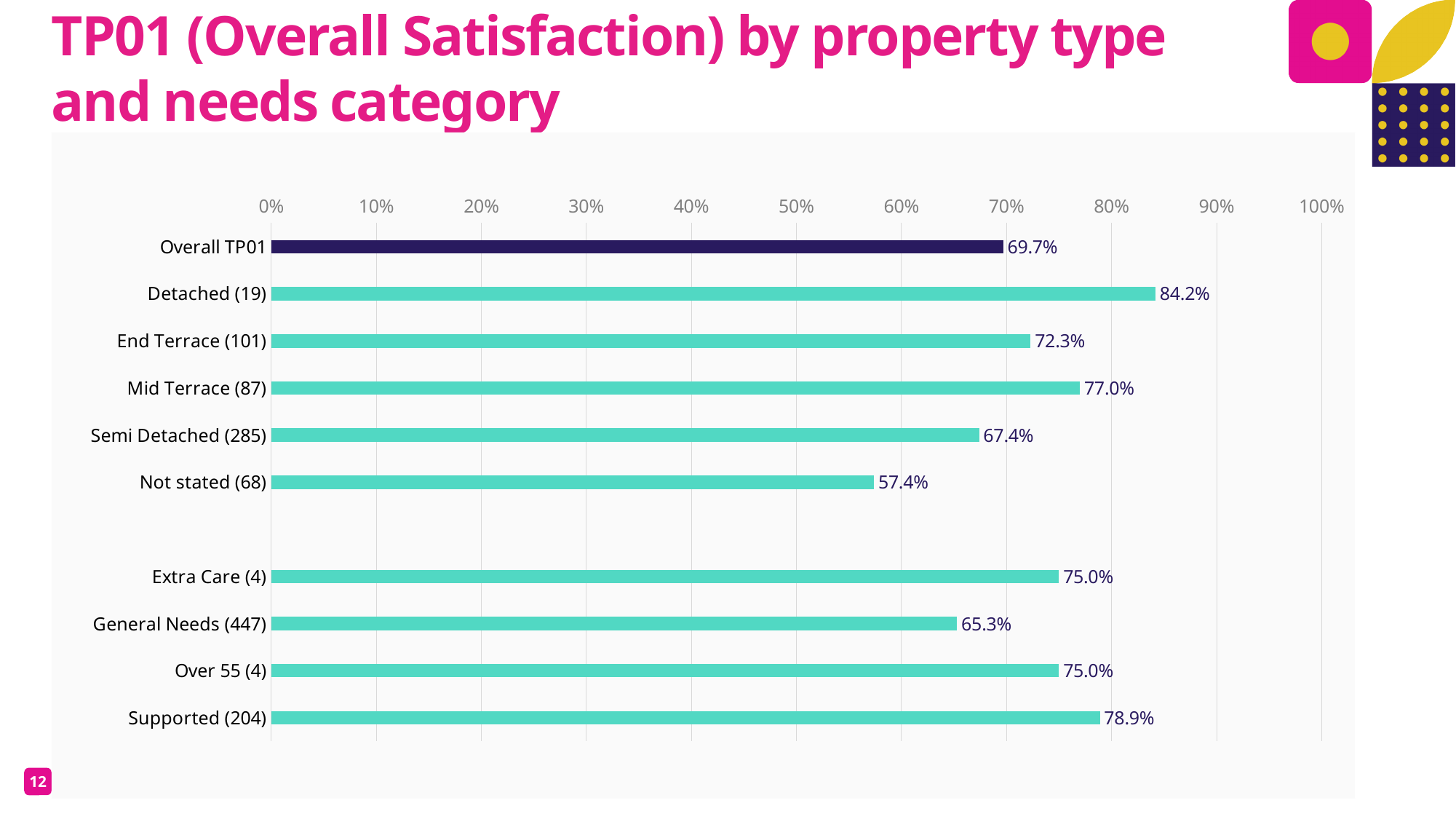
What is the value for Supported (204)? 78.9% What is the value for Detached (19)? 84.2% How many bars are plotted on the chart? 10 What is the value for Not stated (68)? 57.4% What is the difference between the values for Mid Terrace (87) and End Terrace (101)? 4.7% What kind of chart is shown on the slide? bar chart Which category has the highest value? Detached (19) Which bar is shown in a different colour (dark navy) from the others? Overall TP01 Which category has the lowest value? Not stated (68) Is the value for Extra Care (4) greater or less than 70%? greater Which is larger, the value for Semi Detached (285) or the value for General Needs (447)? Semi Detached (285) What is the value for Overall TP01? 69.7%